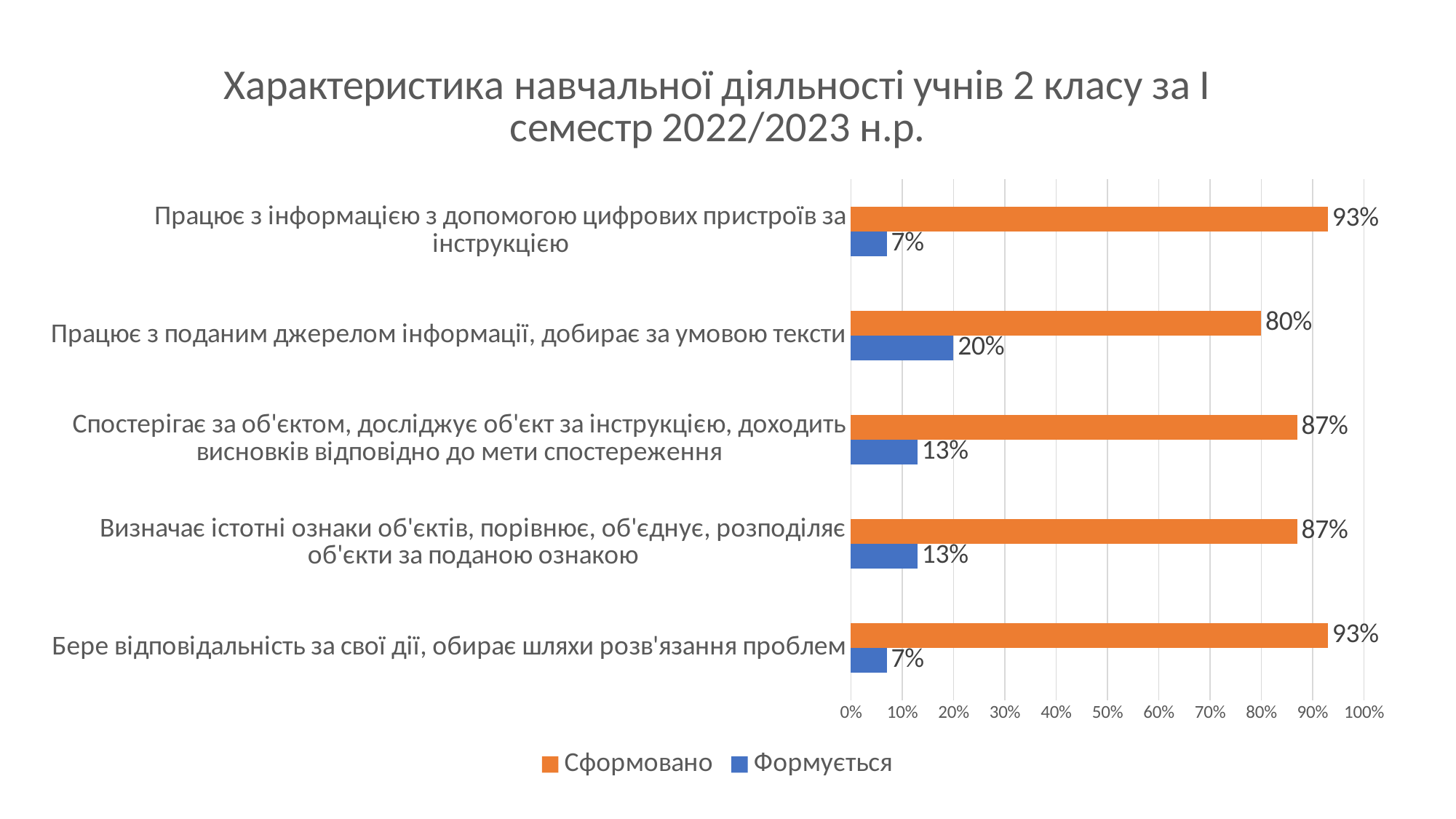
Which category has the highest "Формується" value? Працює з поданим джерелом інформації, добирає за умовою тексти What type of chart is shown on the slide? bar chart What is the difference between the "Сформовано" and "Формується" values for "Спостерігає за об'єктом, досліджує об'єкт за інструкцією, доходить висновків відповідно до мети спостереження"? 74% Which category has the lowest "Сформовано" value? Працює з поданим джерелом інформації, добирає за умовою тексти How many series does the legend list? 2 What is the value of "Сформовано" for "Бере відповідальність за свої дії, обирає шляхи розв'язання проблем"? 93% What is the value of "Формується" for "Працює з поданим джерелом інформації, добирає за умовою тексти"? 20% What is the value of "Формується" for "Визначає істотні ознаки об'єктів, порівнює, об'єднує, розподіляє об'єкти за поданою ознакою"? 13% How many categories are plotted on the chart? 5 What is the value of "Сформовано" for "Працює з поданим джерелом інформації, добирає за умовою тексти"? 80% Which colour represents the "Формується" series? blue Which is larger: the "Сформовано" value for "Працює з інформацією з допомогою цифрових пристроїв за інструкцією" or for "Працює з поданим джерелом інформації, добирає за умовою тексти"? Працює з інформацією з допомогою цифрових пристроїв за інструкцією